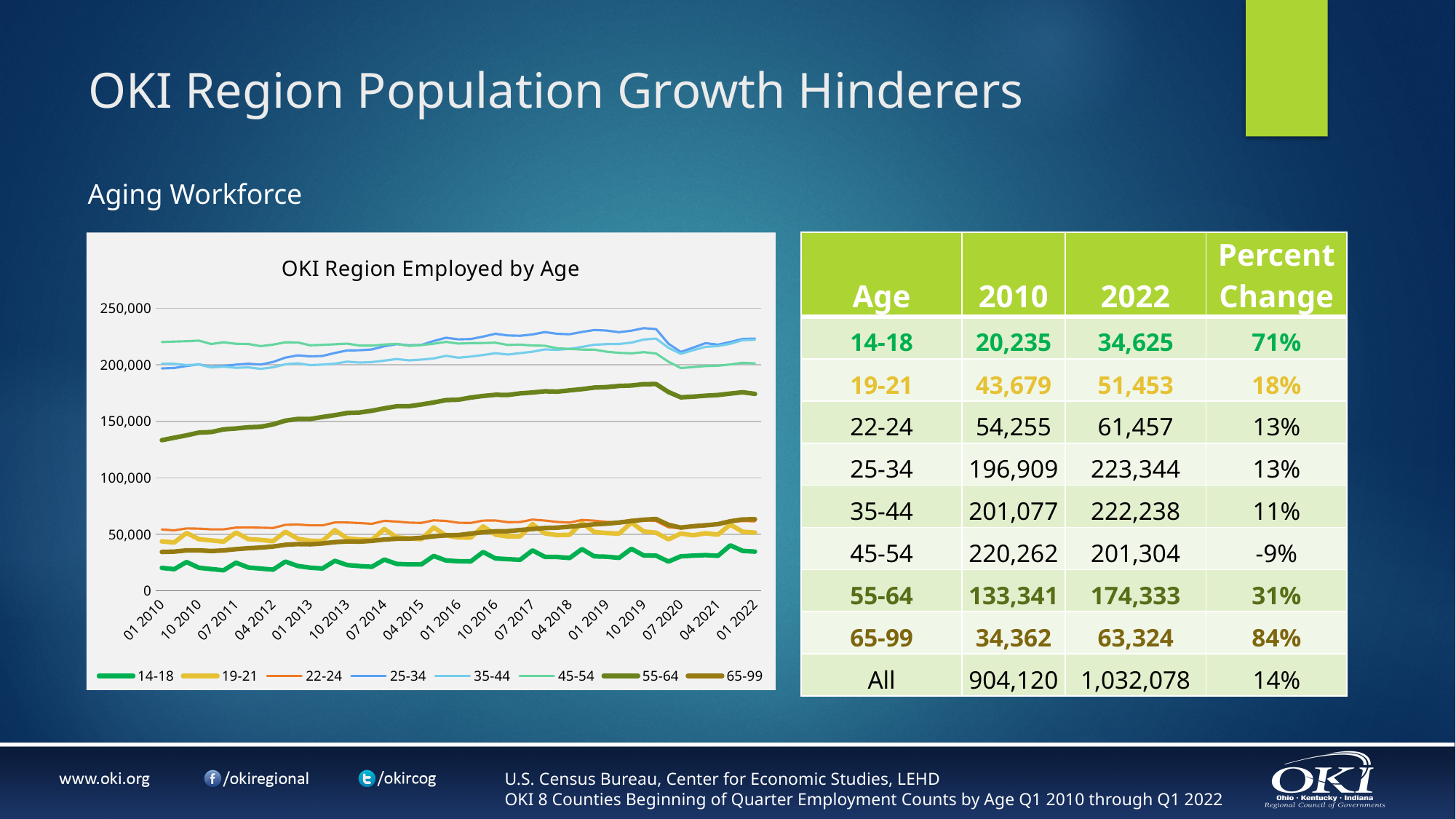
What is the last x-axis label shown on the 'OKI Region Employed by Age' chart? 01 2022 In the 'OKI Region Employed by Age' chart, which age group has the highest line at 01 2010? 45-54 In the 'OKI Region Employed by Age' chart, which age group has the lowest line throughout the period? 14-18 In the 'OKI Region Employed by Age' chart, which is larger at 01 2010: the 22-24 line or the 19-21 line? 22-24 What is the title of the chart on the slide? OKI Region Employed by Age In the 'OKI Region Employed by Age' chart, is the value for 55-64 at 01 2010 greater or less than 150,000? less In the 'OKI Region Employed by Age' chart, is the value for 65-99 at 01 2022 greater or less than 50,000? greater How many series does the legend of the 'OKI Region Employed by Age' chart list? 8 In the 'OKI Region Employed by Age' chart, does the 55-64 line rise or fall from 01 2010 to 10 2019? rise In the 'OKI Region Employed by Age' chart, is the value for 55-64 at 10 2019 greater or less than 150,000? greater In the 'OKI Region Employed by Age' chart, does the 45-54 line rise or fall from 01 2010 to 01 2022? fall What kind of chart is 'OKI Region Employed by Age'? line chart